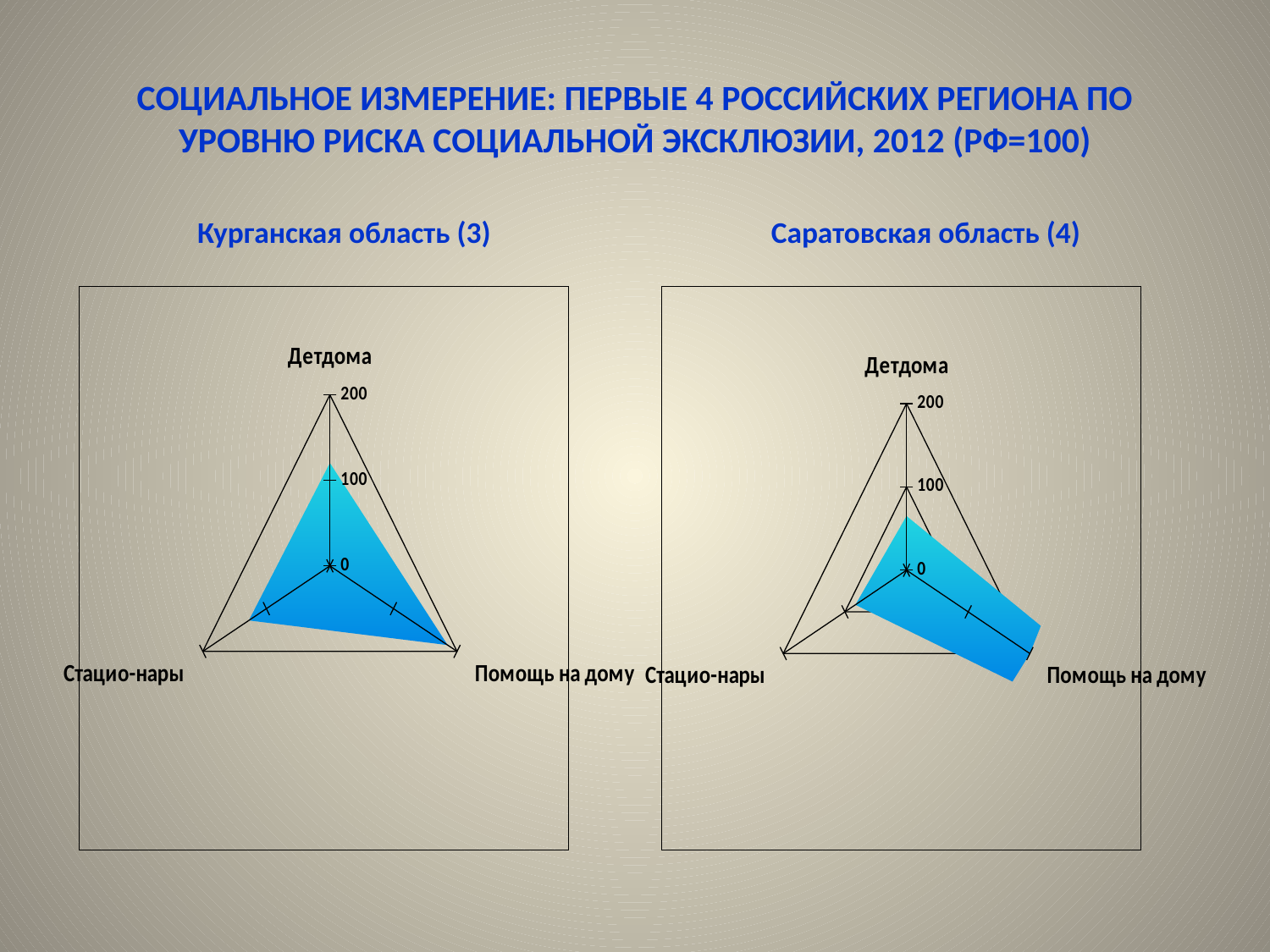
How many categories (axes) does the Саратовская область (4) chart have? 3 How many radar charts are shown on the slide? 2 In the Курганская область (3) chart, which category has the highest value? Помощь на дому In the Курганская область (3) chart, is the value for Помощь на дому greater or less than 100? greater In the Курганская область (3) chart, is the value for Детдома greater or less than 100? greater What kind of chart is used for Курганская область (3)? radar chart In the Саратовская область (4) chart, which category has the highest value? Помощь на дому In the Саратовская область (4) chart, is the value for Помощь на дому greater or less than 100? greater In the Курганская область (3) chart, which is larger: Детдома or Помощь на дому? Помощь на дому What is the maximum value shown on the axis scale of the Курганская область (3) chart? 200 In the Саратовская область (4) chart, which is larger: Стацио-нары or Помощь на дому? Помощь на дому